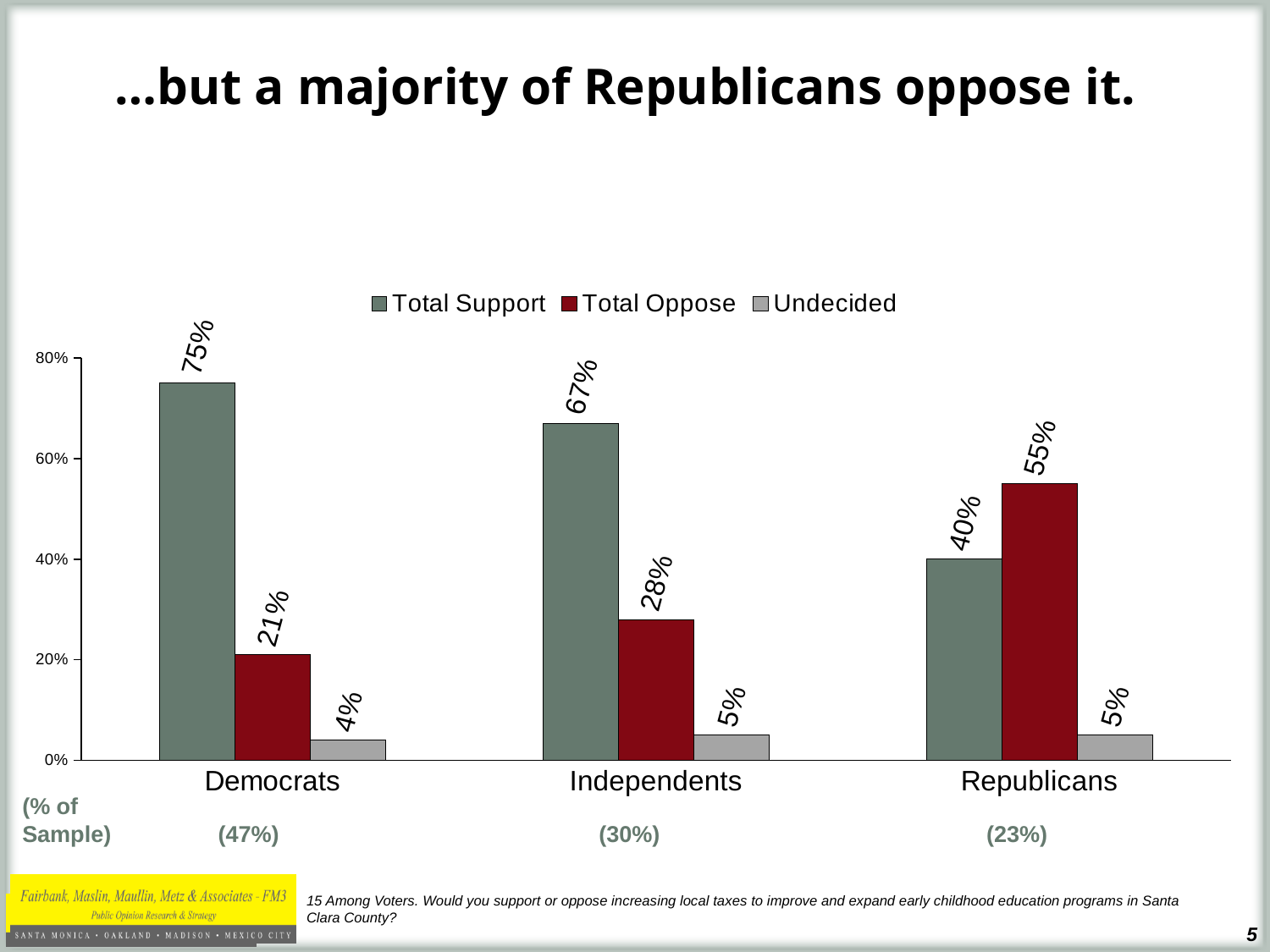
How many groups are shown on the x axis? 3 What is the difference in Total Support between Democrats and Independents? 8% What is the Undecided value for Independents? 5% What is the difference between Total Support and Total Oppose for Republicans? 15% How many series does the legend list? 3 What percentage of the sample are Republicans, as shown below the chart? 23% Which group has the lowest Total Oppose value? Democrats Which group has the highest Total Support value? Democrats What kind of chart is shown on the slide? Bar chart What is the Total Support value for Democrats? 75% Which is larger for Independents, Total Support or Total Oppose? Total Support What is the Total Oppose value for Republicans? 55%